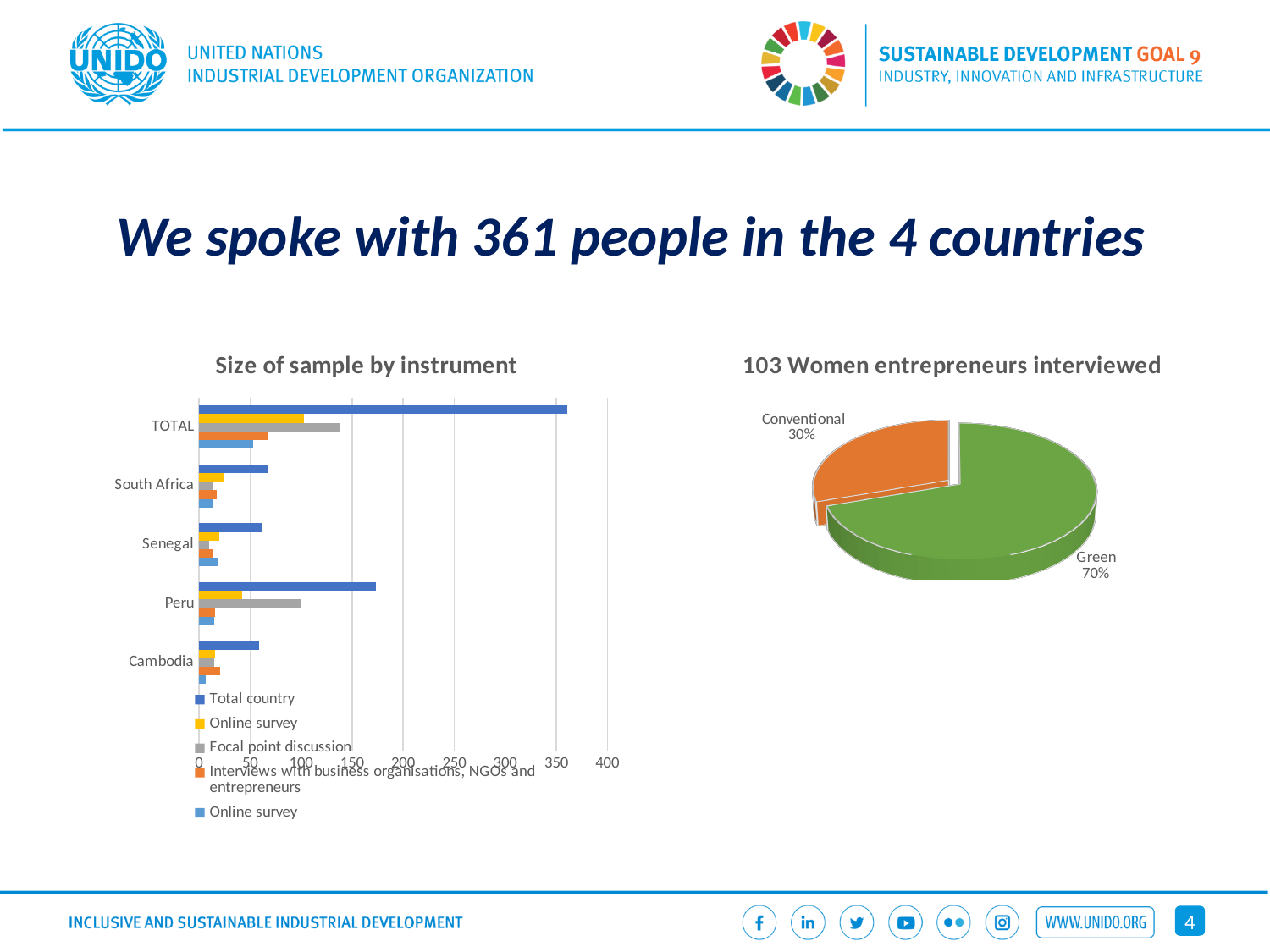
In the 'Size of sample by instrument' chart, which country (excluding TOTAL) has the highest 'Total country' value? Peru In the '103 Women entrepreneurs interviewed' chart, what share of the pie is Green? 70% In the '103 Women entrepreneurs interviewed' chart, what is the difference in percentage points between Green and Conventional? 40 In the '103 Women entrepreneurs interviewed' chart, what is the value for Conventional? 30% In the '103 Women entrepreneurs interviewed' chart, what kind of chart is it? pie chart In the 'Size of sample by instrument' chart, is the 'Total country' value for TOTAL greater or less than 300? greater In the 'Size of sample by instrument' chart, is the 'Total country' value for Peru greater or less than 150? greater In the 'Size of sample by instrument' chart, how many categories are shown on the vertical axis? 5 In the 'Size of sample by instrument' chart, what kind of chart is it? bar chart In the 'Size of sample by instrument' chart, which is larger, the 'Total country' value for Peru or for South Africa? Peru In the 'Size of sample by instrument' chart, how many series does the legend list? 5 In the 'Size of sample by instrument' chart, is the 'Total country' value for South Africa greater or less than 100? less